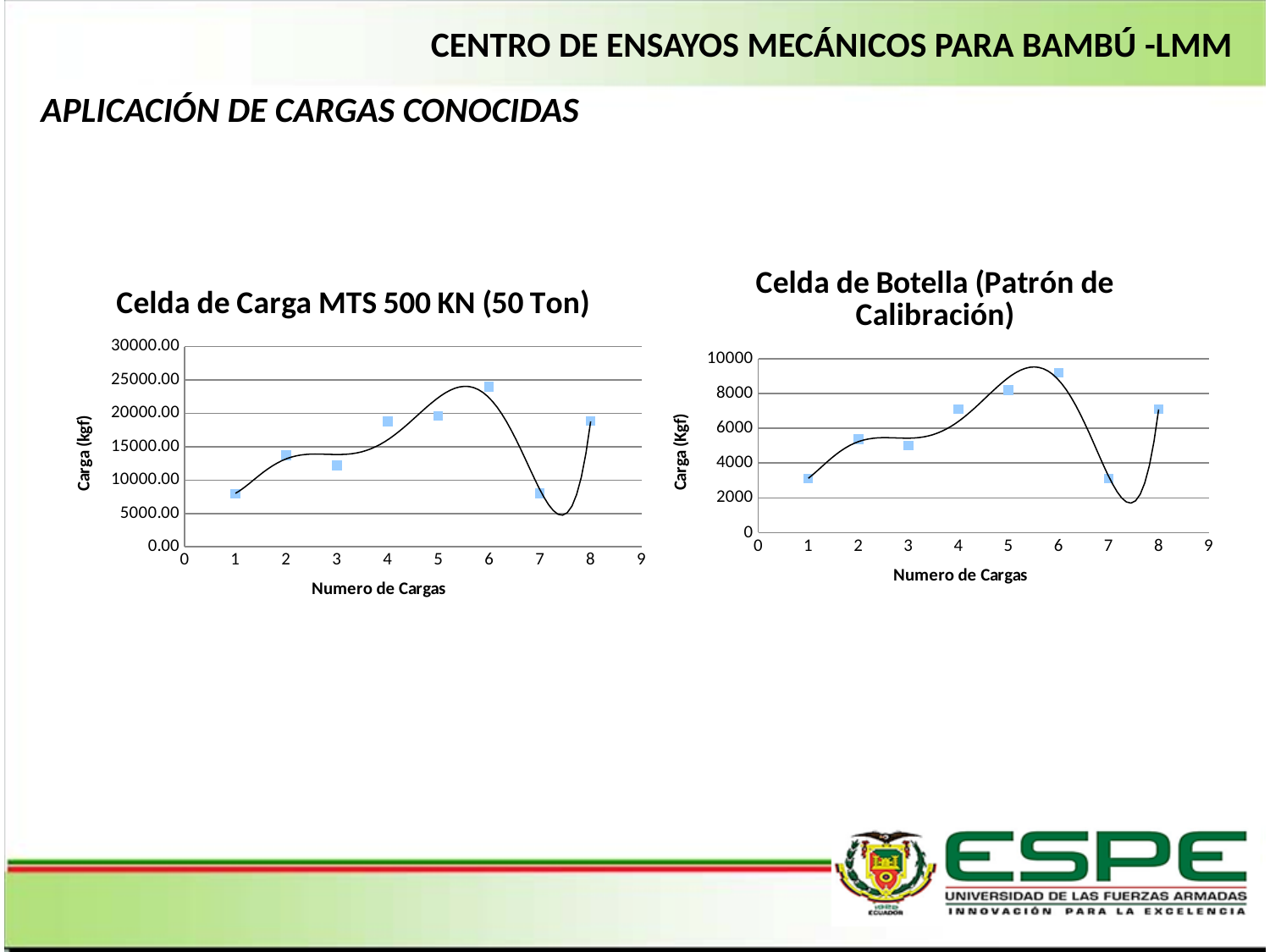
In the 'Celda de Botella (Patrón de Calibración)' chart, is the value at load number 6 greater or less than 8000? greater In the 'Celda de Carga MTS 500 KN (50 Ton)' chart, at which load number (Numero de Cargas) is the value highest? 6 How many data points are plotted in the 'Celda de Carga MTS 500 KN (50 Ton)' chart? 8 What kind of chart is the 'Celda de Carga MTS 500 KN (50 Ton)' chart? scatter chart In the 'Celda de Carga MTS 500 KN (50 Ton)' chart, is the value at load number 1 greater or less than 10000.00? less In the 'Celda de Botella (Patrón de Calibración)' chart, at which load number (Numero de Cargas) is the value highest? 6 How many data points are plotted in the 'Celda de Botella (Patrón de Calibración)' chart? 8 In the 'Celda de Carga MTS 500 KN (50 Ton)' chart, which has the larger value: load number 3 or load number 4? load number 4 What is the x-axis title of the 'Celda de Botella (Patrón de Calibración)' chart? Numero de Cargas In the 'Celda de Botella (Patrón de Calibración)' chart, is the value at load number 7 greater or less than 4000? less In the 'Celda de Botella (Patrón de Calibración)' chart, which has the larger value: load number 2 or load number 5? load number 5